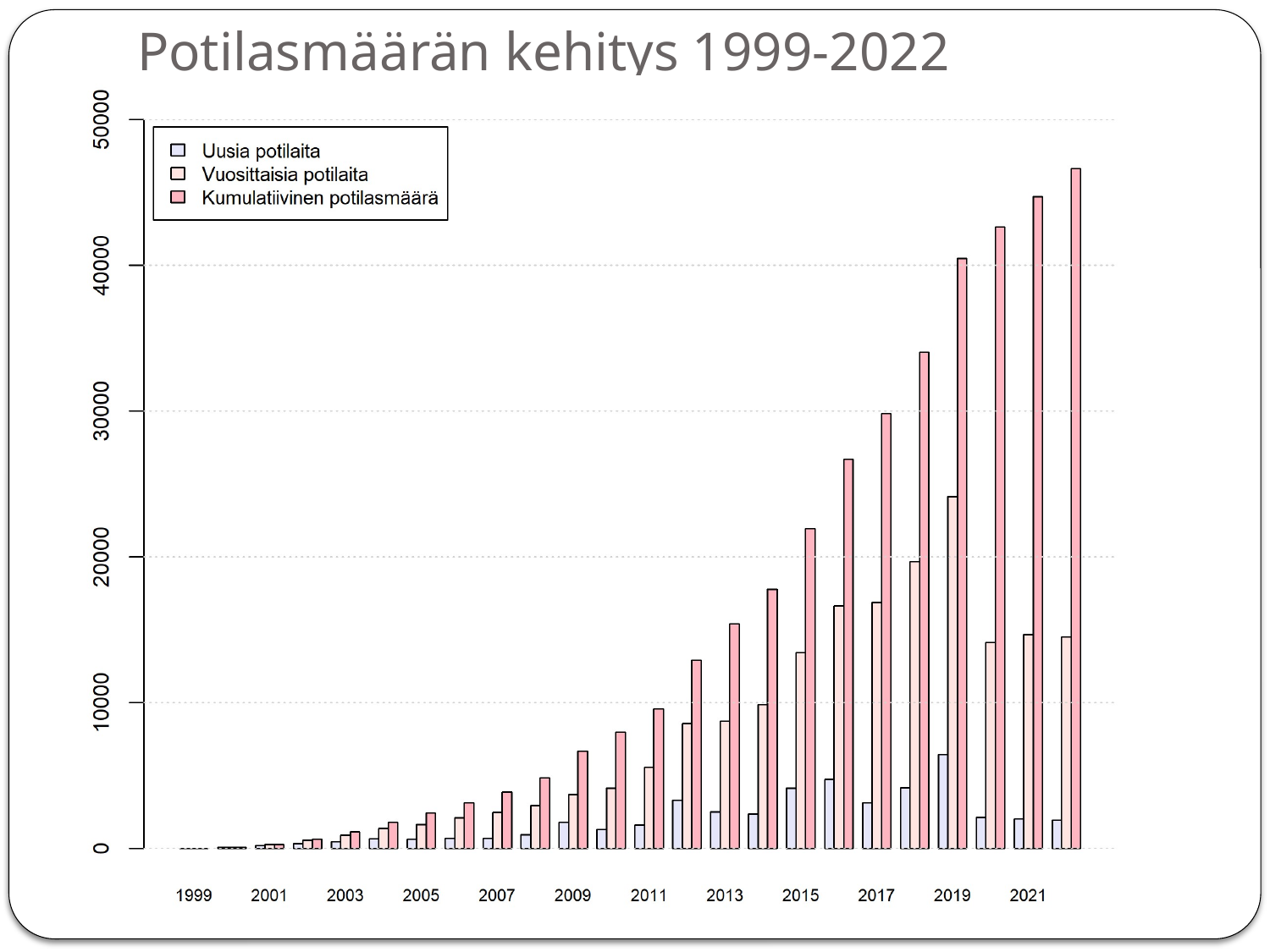
Is the Uusia potilaita value for 2019 greater or less than 10000? less Is the Kumulatiivinen potilasmäärä value for 2018 greater or less than 30000? greater Is the Kumulatiivinen potilasmäärä value for 2022 greater or less than 40000? greater Does the Kumulatiivinen potilasmäärä series rise or fall from 1999 to 2022? rise In which year is the Uusia potilaita bar the highest? 2019 In which year is the Kumulatiivinen potilasmäärä bar the highest? 2022 What kind of chart is shown on the slide? bar chart Which series is shown in the darkest pink colour in the legend? Kumulatiivinen potilasmäärä In which year is the Vuosittaisia potilaita bar the highest? 2019 What is the title of the chart? Potilasmäärän kehitys 1999-2022 How many series does the legend list? 3